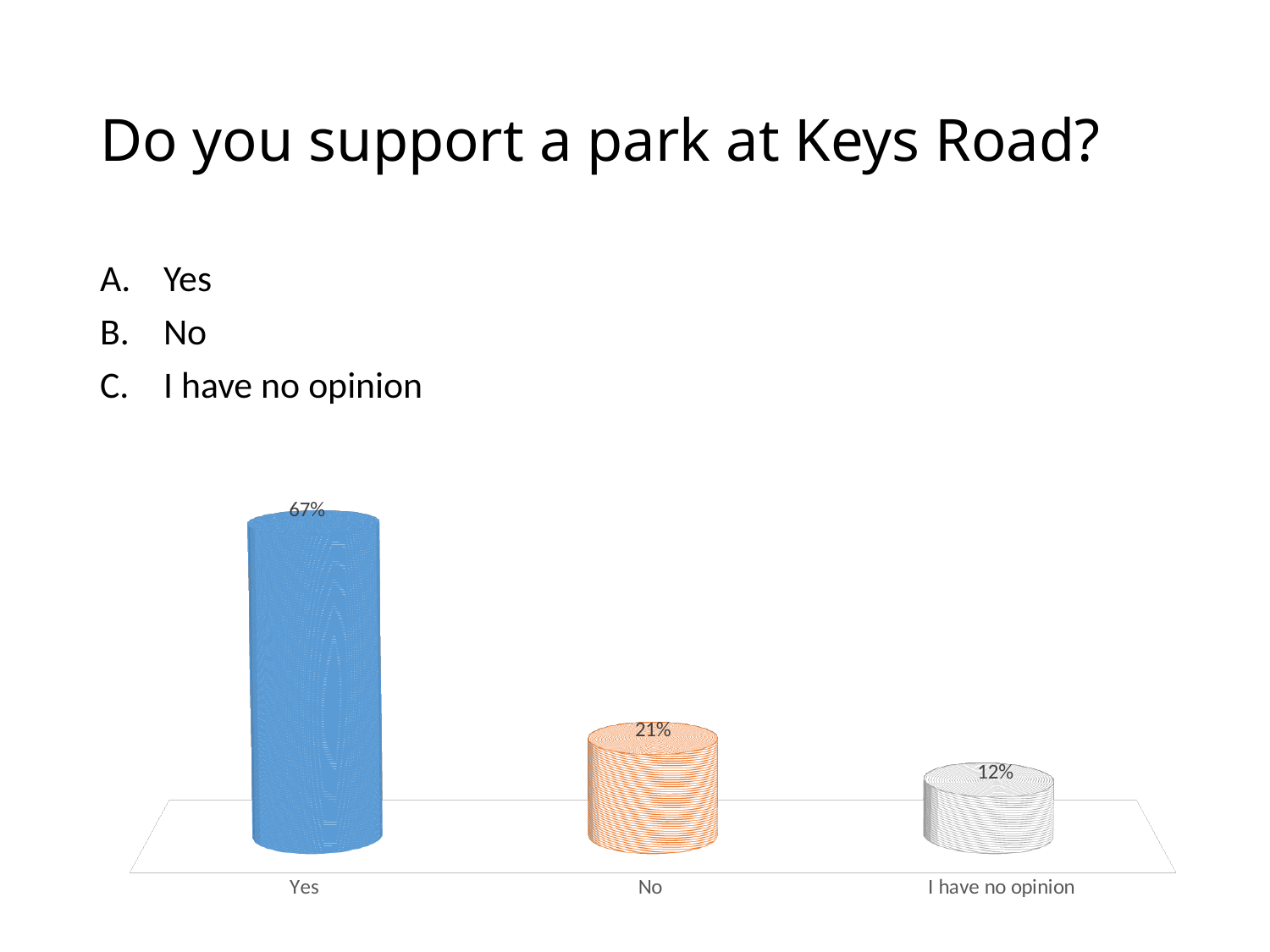
Do the values rise or fall from left to right across the categories? Fall What is the difference in percentage points between "No" and "I have no opinion"? 9 How many response categories are shown in the chart? 3 What colour is the bar for "Yes"? Blue Which response has the lowest percentage? I have no opinion What percentage of respondents answered "No"? 21% What is the difference in percentage points between "Yes" and "No"? 46 What percentage of respondents answered "Yes"? 67% What percentage of respondents answered "I have no opinion"? 12% Which is larger, the percentage for "No" or for "I have no opinion"? No Which response has the highest percentage? Yes What kind of chart is shown on the slide? Bar chart